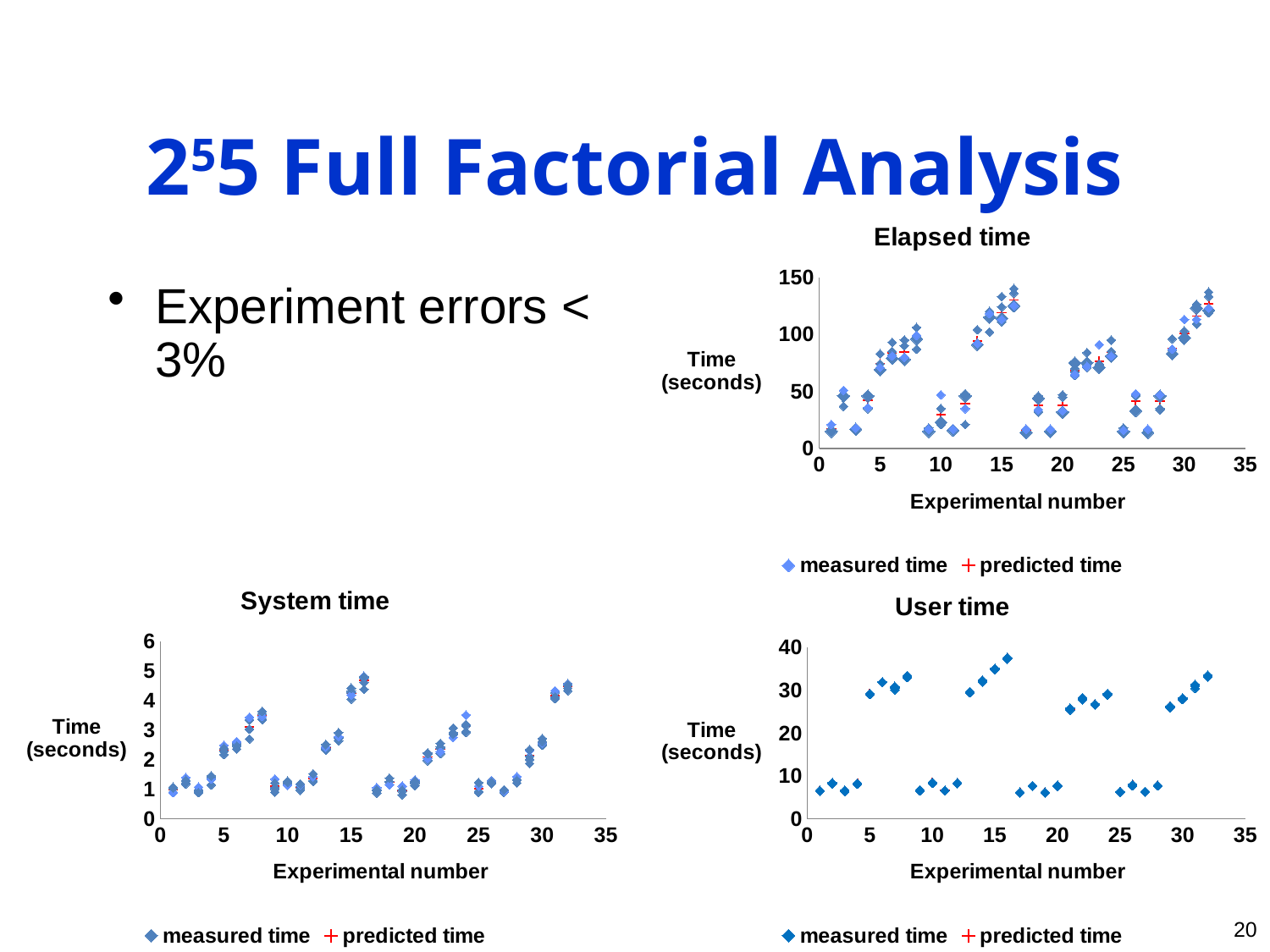
What is the label of the x axis on the Elapsed time chart? Experimental number In the System time chart, is the measured time for experiment number 1 greater or less than 2? less In the User time chart, is the measured time for experiment number 1 greater or less than 10? less What are the two legend entries on the User time chart? measured time, predicted time What kind of chart is the Elapsed time chart? scatter chart In the Elapsed time chart, is the measured time for experiment number 16 greater or less than 100? greater In the User time chart, is the measured time for experiment number 16 larger or smaller than that for experiment number 1? larger How many series does the legend of the System time chart list? 2 In the User time chart, which experimental number has the highest measured time? 16